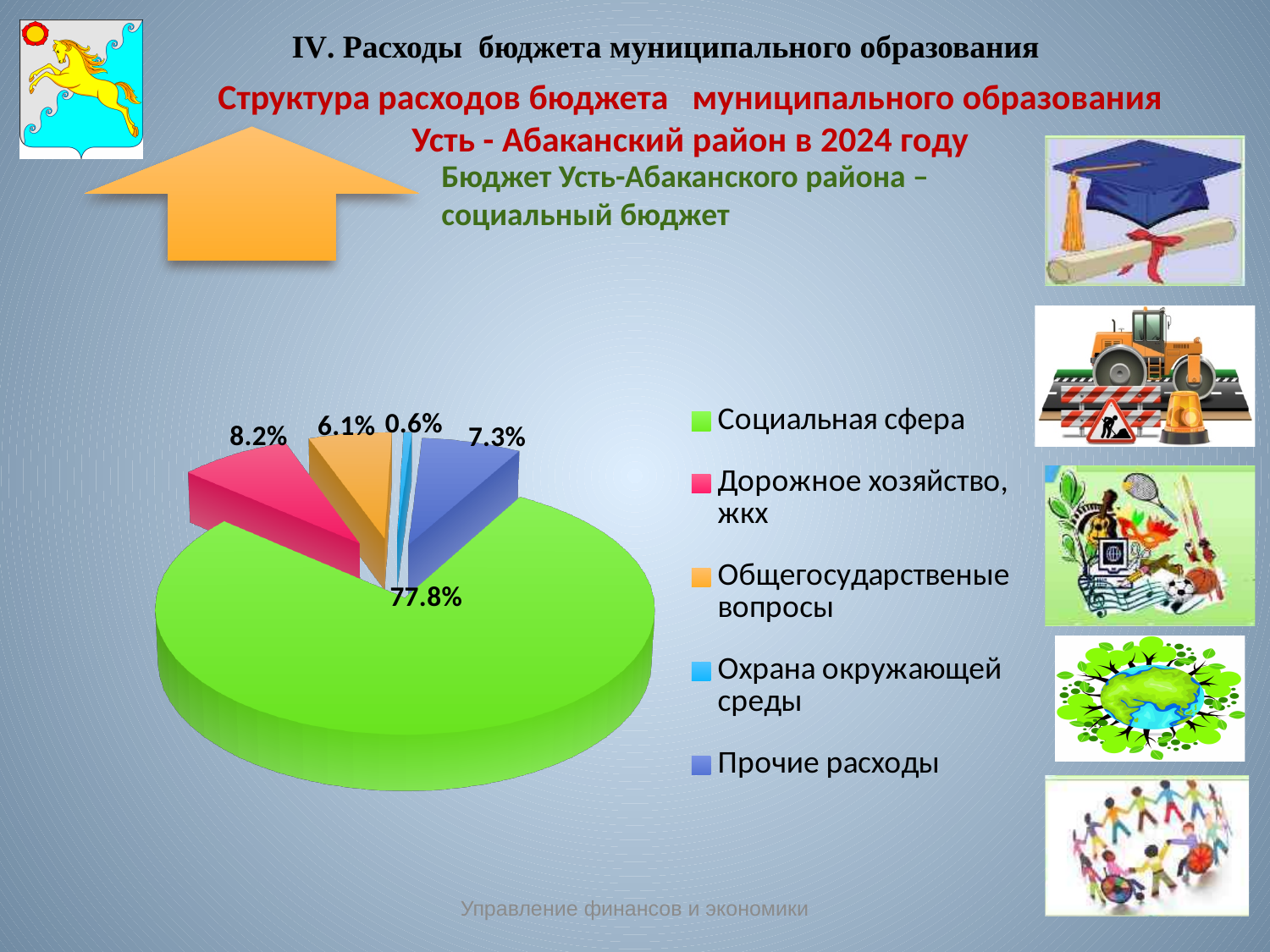
What is the value shown for Общегосударственые вопросы? 6.1% What colour is the slice for Социальная сфера? green What kind of chart is shown on the slide? pie chart What is the value shown for Дорожное хозяйство, жкх? 8.2% Which category has the largest share of the pie? Социальная сфера What is the value shown for Прочие расходы? 7.3% Which category has the smallest share of the pie? Охрана окружающей среды Which is larger: the share of Общегосударственые вопросы or the share of Прочие расходы? Прочие расходы How many categories does the pie chart have? 5 What share of the pie does Социальная сфера take? 77.8% What is the difference between the shares of Дорожное хозяйство, жкх and Прочие расходы? 0.9% What is the value shown for Охрана окружающей среды? 0.6%